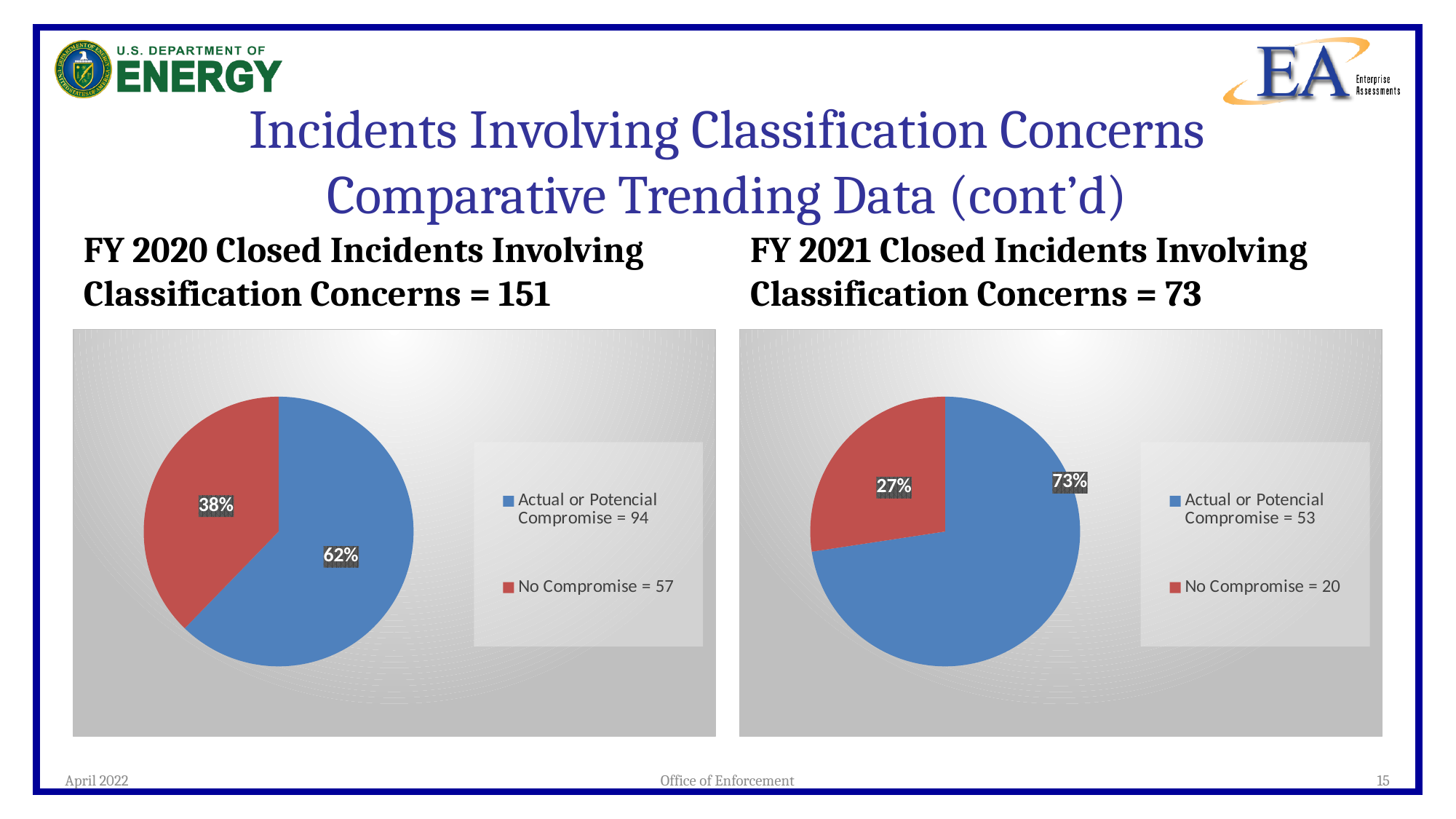
In the FY 2021 pie chart, what is the difference between the Actual or Potencial Compromise count and the No Compromise count? 33 In the FY 2020 pie chart, what is the difference between the Actual or Potencial Compromise count and the No Compromise count? 37 In the FY 2021 pie chart, what percentage share is labeled for the No Compromise slice? 27% What type of chart is used on the left side of the slide for FY 2020? Pie chart In the FY 2021 pie chart, which category has the smaller slice? No Compromise In the FY 2021 pie chart, how many incidents does the legend give for No Compromise? 20 How many entries does the legend of the FY 2021 pie chart list? 2 In the FY 2020 pie chart, which category has the larger slice? Actual or Potencial Compromise In the FY 2020 pie chart, what percentage share is labeled for the Actual or Potencial Compromise slice? 62% In the FY 2020 pie chart, what percentage share is labeled for the No Compromise slice? 38% In the FY 2020 pie chart, how many incidents does the legend give for Actual or Potencial Compromise? 94